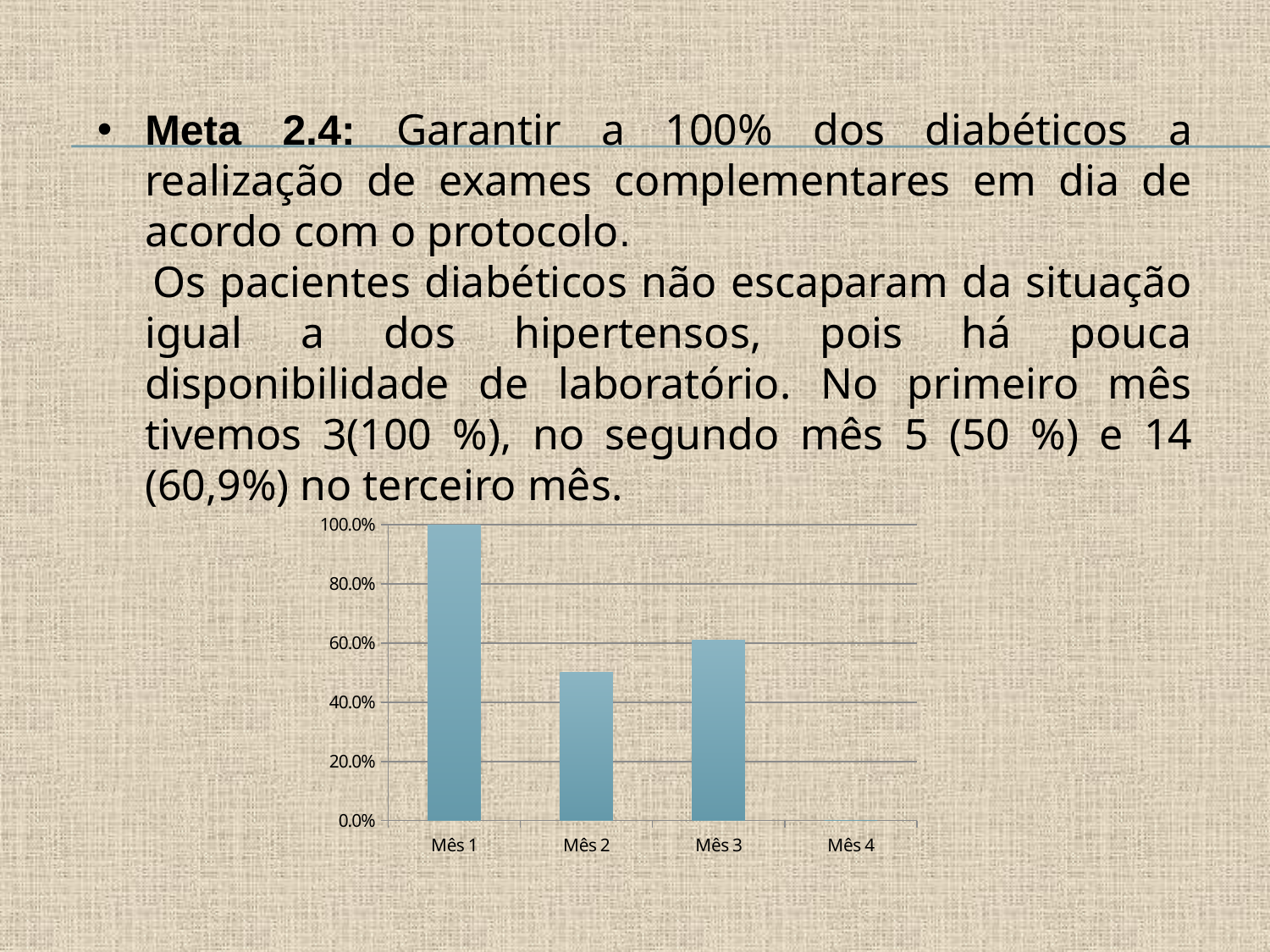
Does the value rise or fall from Mês 1 to Mês 2? fall Is the value for Mês 3 greater or less than 80.0%? less Which is larger, the value for Mês 1 or the value for Mês 2? Mês 1 Is the value for Mês 3 greater or less than 40.0%? greater What is the value for Mês 1 in the chart? 100.0% What kind of chart is shown on the slide? bar chart Which month has the highest bar in the chart? Mês 1 Which is larger, the value for Mês 3 or the value for Mês 2? Mês 3 How many categories are shown on the x axis of the chart? 4 What is the highest value shown on the y axis of the chart? 100.0% Is the value for Mês 2 greater or less than 60.0%? less